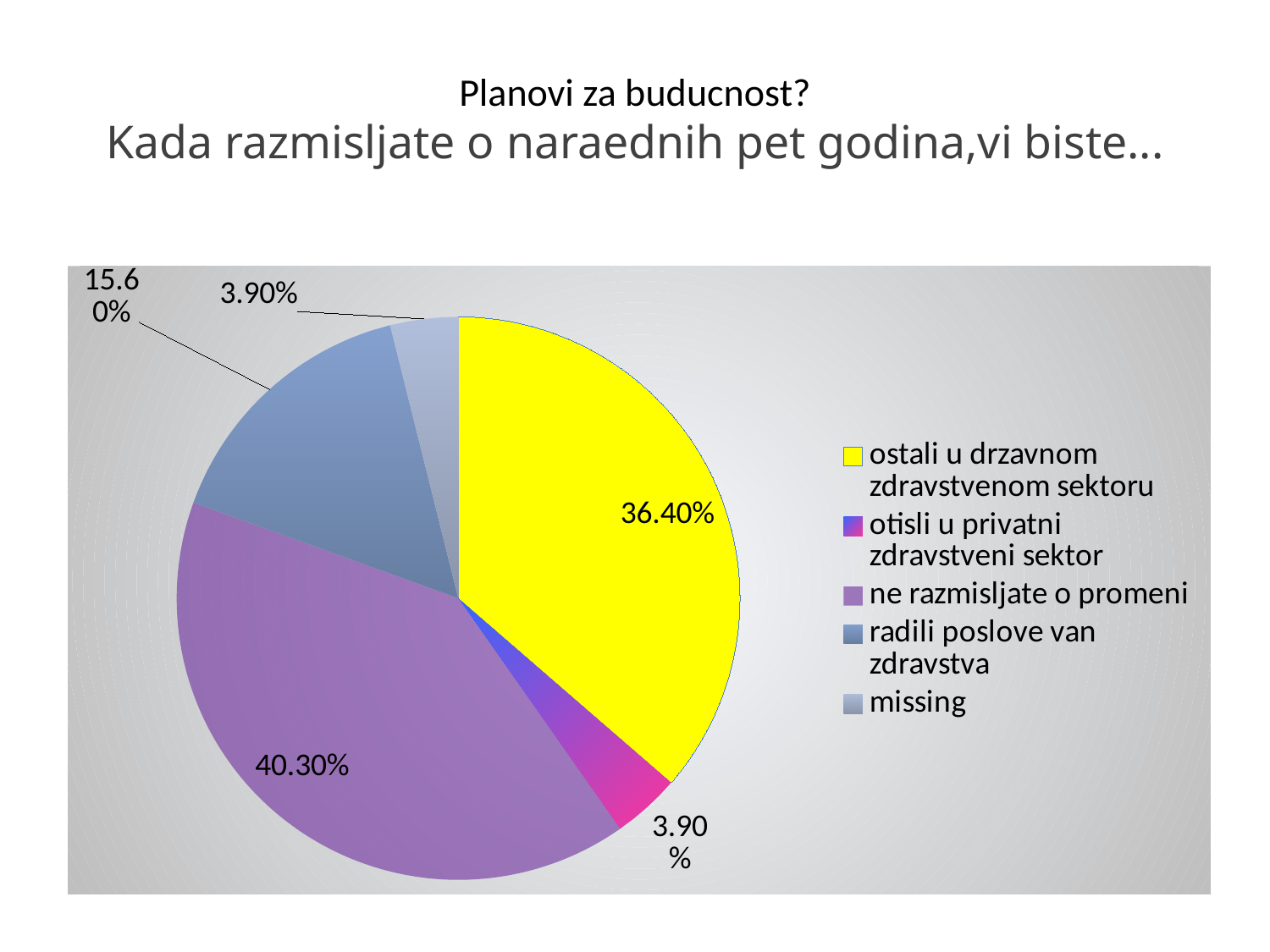
What is the value shown for the "missing" slice? 3.90% What is the value shown for "ostali u drzavnom zdravstvenom sektoru"? 36.40% What kind of chart is shown on the slide? pie chart What is the difference between the shares for "ostali u drzavnom zdravstvenom sektoru" and "radili poslove van zdravstva"? 20.80% What is the value shown for "radili poslove van zdravstva"? 15.60% What is the difference between the shares for "ne razmisljate o promeni" and "ostali u drzavnom zdravstvenom sektoru"? 3.90% How many slices does the pie chart have? 5 Which is larger: "ostali u drzavnom zdravstvenom sektoru" or "ne razmisljate o promeni"? ne razmisljate o promeni What percentage of the pie is labelled for "ne razmisljate o promeni"? 40.30% What is the value shown for "otisli u privatni zdravstveni sektor"? 3.90% Which category is shown in yellow in the legend? ostali u drzavnom zdravstvenom sektoru Which category has the largest share of the pie? ne razmisljate o promeni